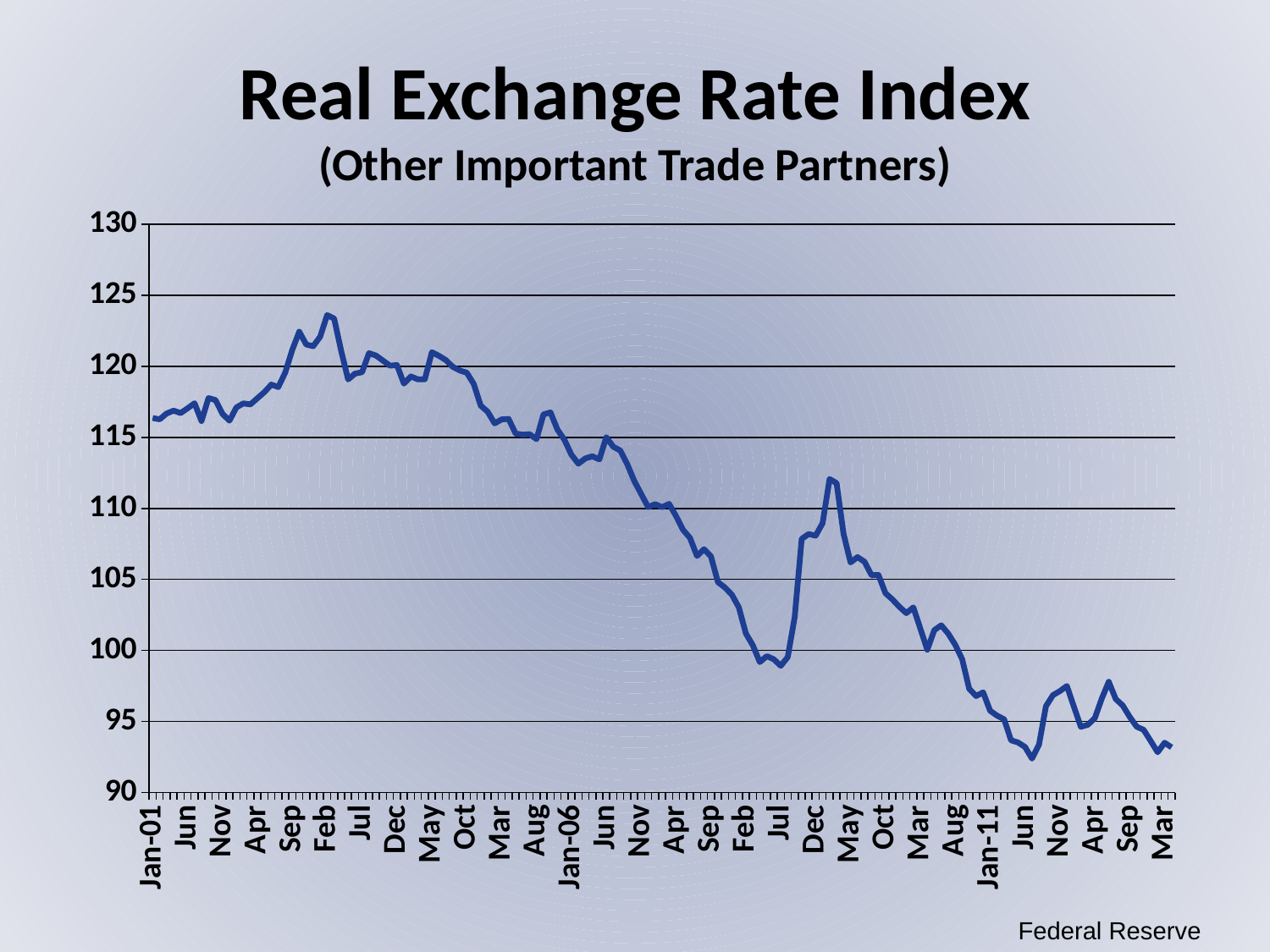
Is the value for Jan-06 greater or less than 120? less What is the lowest value shown on the vertical axis? 90 Is the value for Jan-11 greater or less than 100? less Is the value for Jan-01 larger or smaller than the value for Jan-11? larger What is the title of the chart? Real Exchange Rate Index (Other Important Trade Partners) What source is cited for the chart data? Federal Reserve Is the peak value reached around Feb (2003) greater or less than 120? greater Overall, does the Real Exchange Rate Index rise or fall from Jan-01 to the end of the series? fall What kind of chart is shown on the slide? line chart